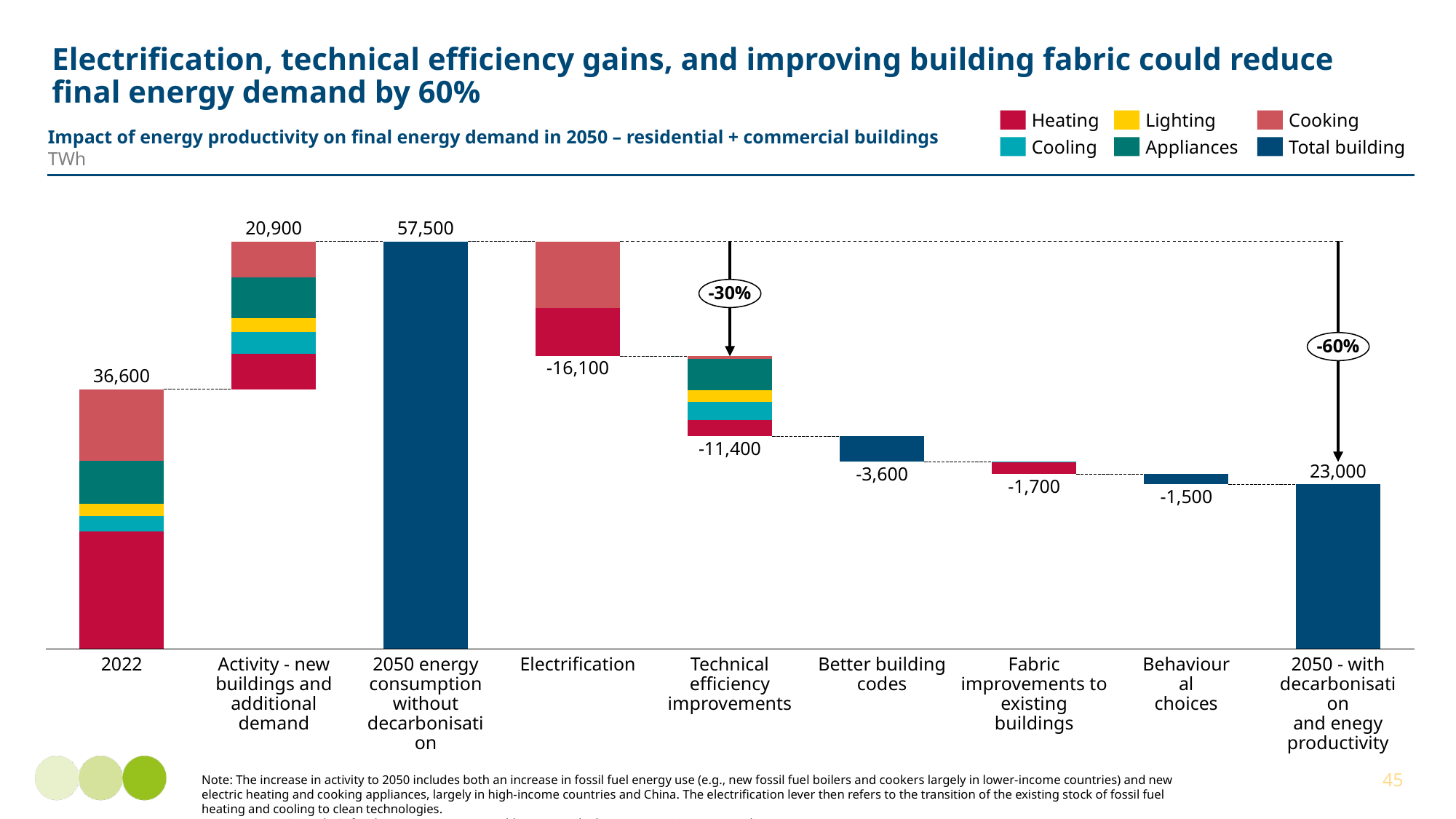
Which step represents a larger reduction, Electrification or Technical efficiency improvements? Electrification What is the value shown for 2022? 36,600 Which category has the highest value on the chart? 2050 energy consumption without decarbonisation What is the value shown for the Electrification step? -16,100 What is the value shown for 2050 - with decarbonisation and energy productivity? 23,000 What unit is the chart measured in? TWh How many categories are shown along the x axis? 9 What is the difference between the 2050 energy consumption without decarbonisation and the 2050 value with decarbonisation and energy productivity? 34,500 What is the value shown for Technical efficiency improvements? -11,400 How many series does the legend list? 6 What is the value shown for 2050 energy consumption without decarbonisation? 57,500 Which reduction step has the smallest reduction? Behavioural choices